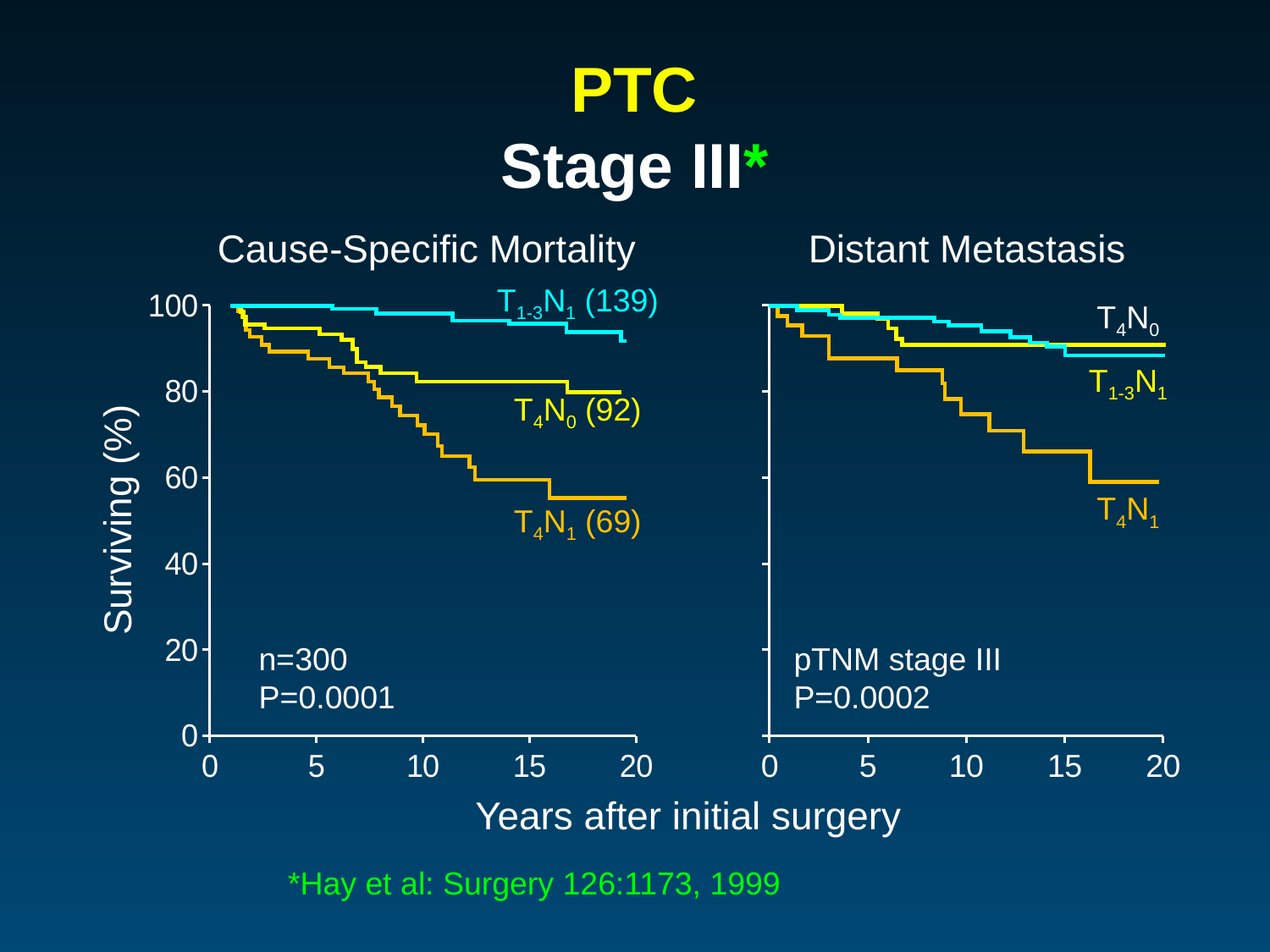
On the Cause-Specific Mortality chart, which group has the lowest surviving percentage at 20 years? T4N1 On the Cause-Specific Mortality chart, is the surviving percentage for T4N1 at 20 years greater or less than 60? less How many series are plotted on the Distant Metastasis chart? 3 On the Cause-Specific Mortality chart, which group has the highest surviving percentage at 20 years? T1-3N1 On the Distant Metastasis chart, is the value for T4N0 at 20 years greater or less than 80? greater How many series are plotted on the Cause-Specific Mortality chart? 3 On the Cause-Specific Mortality chart, how many patients are in the T4N1 group? 69 What P value is shown on the Distant Metastasis chart? P=0.0002 What kind of chart is the Cause-Specific Mortality chart? line chart What is the x-axis label shared by both charts? Years after initial surgery On the Cause-Specific Mortality chart, what is the total n shown? n=300 On the Cause-Specific Mortality chart, how many patients are in the T1-3N1 group? 139